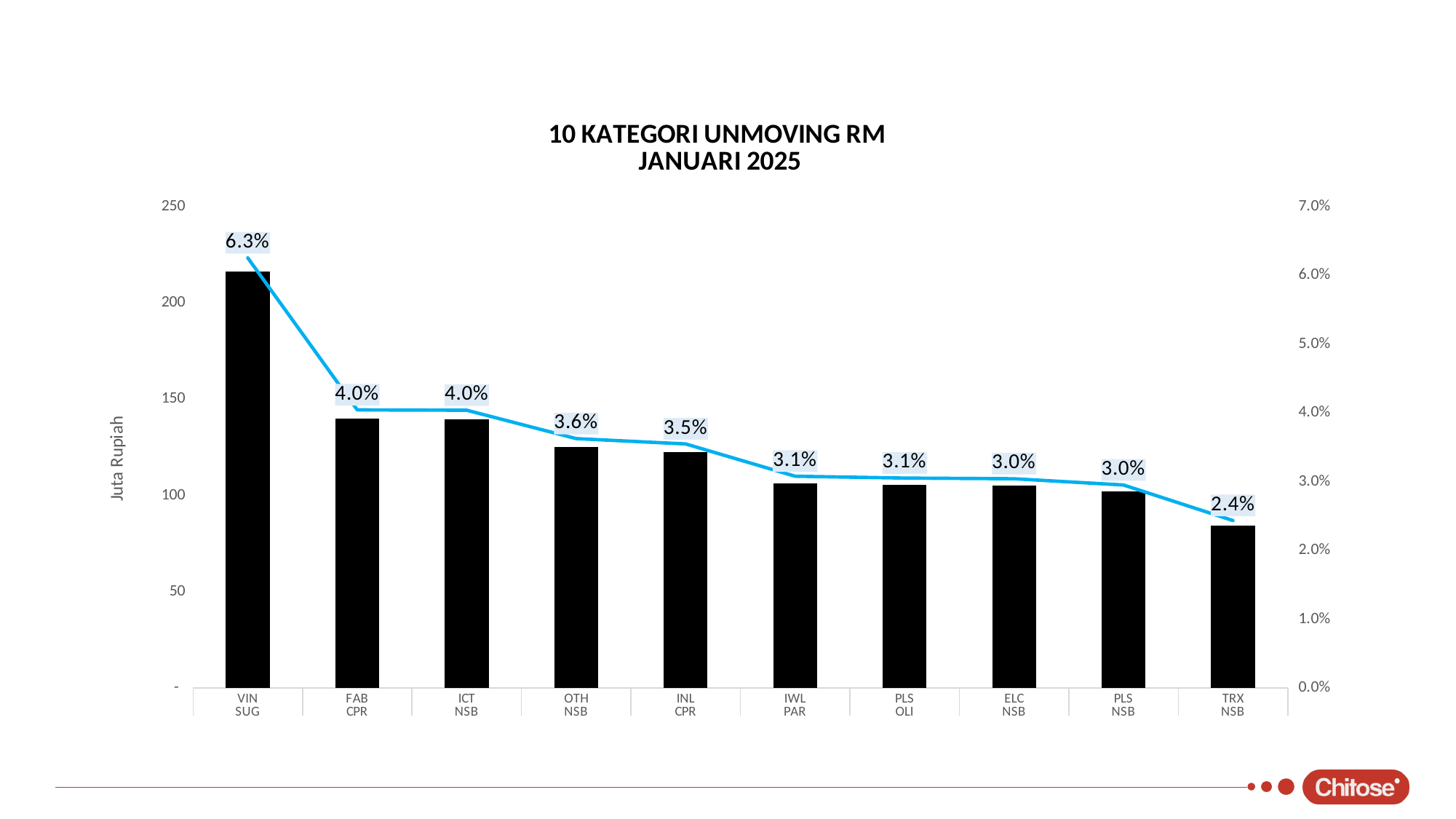
Is the bar value for VIN SUG greater or less than 200? greater What is the label on the left vertical axis? Juta Rupiah What is the difference between the percentage for VIN SUG and the percentage for FAB CPR? 2.3% What percentage is shown for TRX NSB? 2.4% Is the bar value for TRX NSB greater or less than 100? less What percentage is shown for VIN SUG? 6.3% Which has the larger percentage, OTH NSB or INL CPR? OTH NSB Do the percentage values on the line rise or fall from left to right along the x axis? fall Which category has the lowest percentage on the line? TRX NSB How many categories are shown on the x axis? 10 What percentage is shown for OTH NSB? 3.6% Which category has the highest percentage on the line? VIN SUG